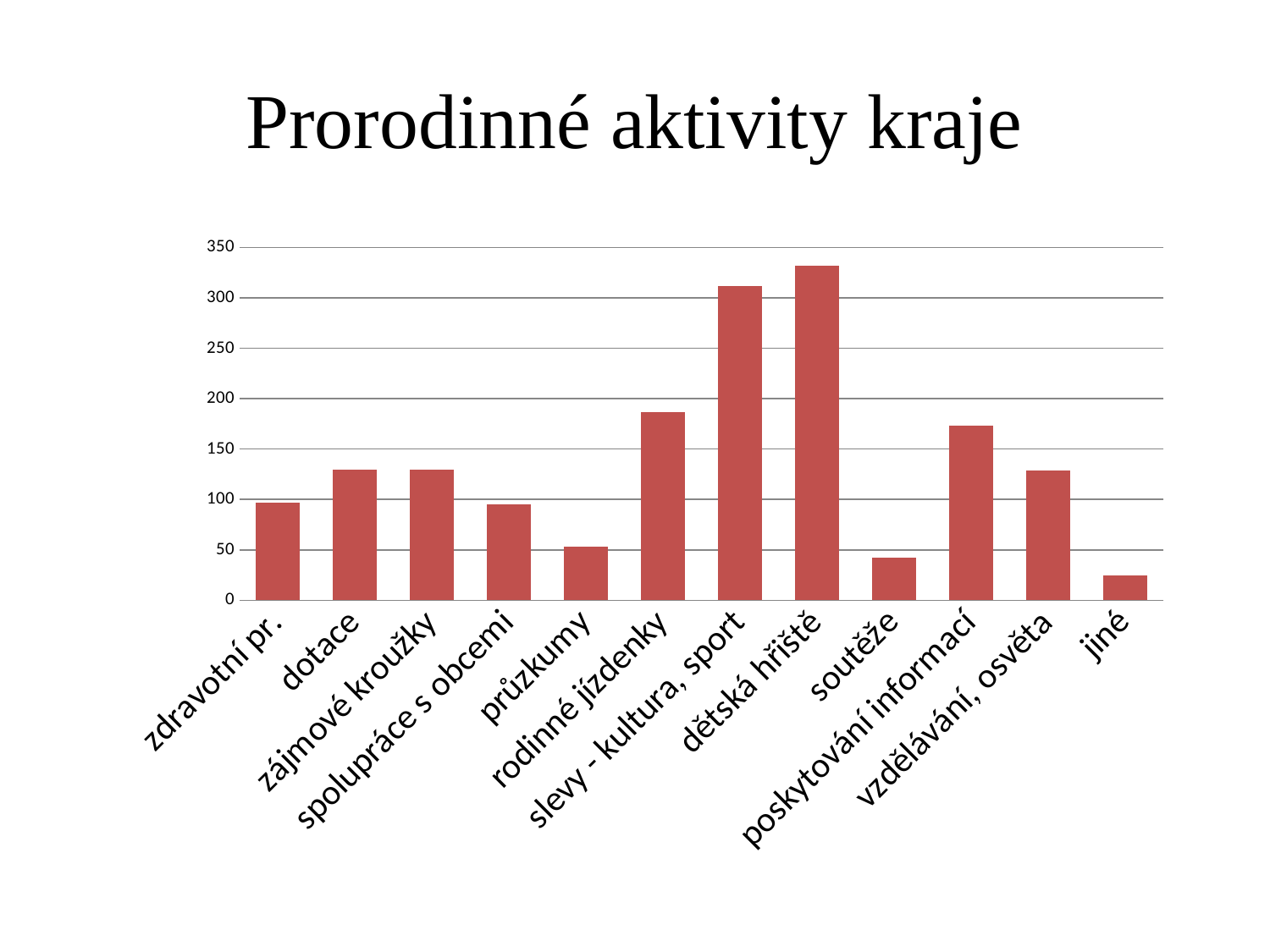
Which category has the lowest value? jiné Is the value for poskytování informací greater or less than 150? greater What kind of chart is shown on the slide? bar chart Which category has the highest value? dětská hřiště Is the value for jiné greater or less than 50? less How many categories are shown on the x axis? 12 Is the value for rodinné jízdenky greater or less than 200? less Which is larger, the value for průzkumy or the value for soutěže? průzkumy Which is larger, the value for slevy - kultura, sport or the value for dětská hřiště? dětská hřiště What is the title of the chart? Prorodinné aktivity kraje